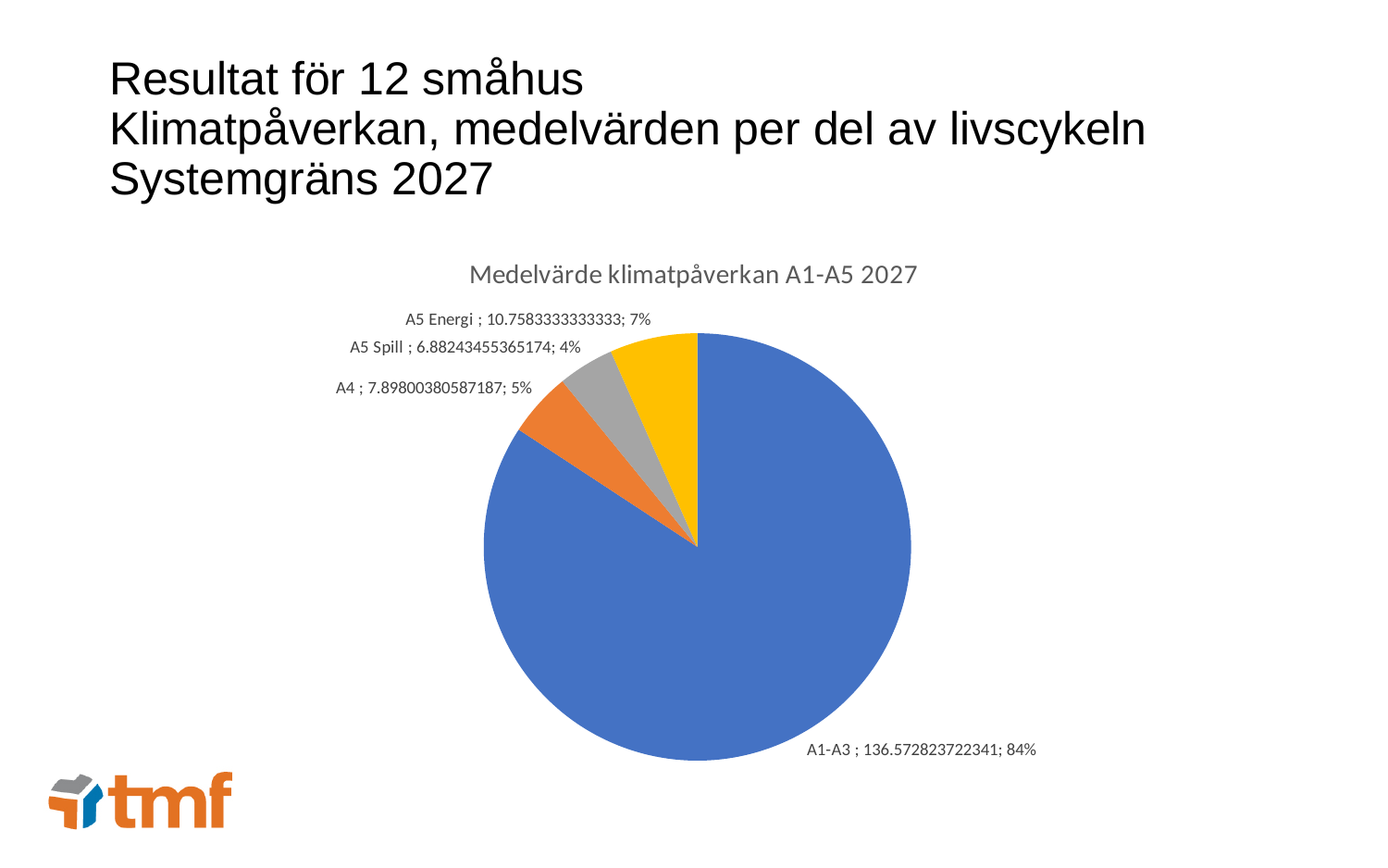
What share of the pie does A4 represent? 5% What is the value shown for A5 Energi? 10.7583333333333 Which category has the largest slice of the pie? A1-A3 Which is larger, the share for A5 Energi or the share for A4? A5 Energi What is the value shown for A1-A3? 136.572823722341 What share of the pie does A5 Spill represent? 4% What is the title of the chart? Medelvärde klimatpåverkan A1-A5 2027 Which category has the smallest slice of the pie? A5 Spill What share of the pie does A1-A3 represent? 84% What kind of chart is shown on the slide? Pie chart How many slices does the pie chart have? 4